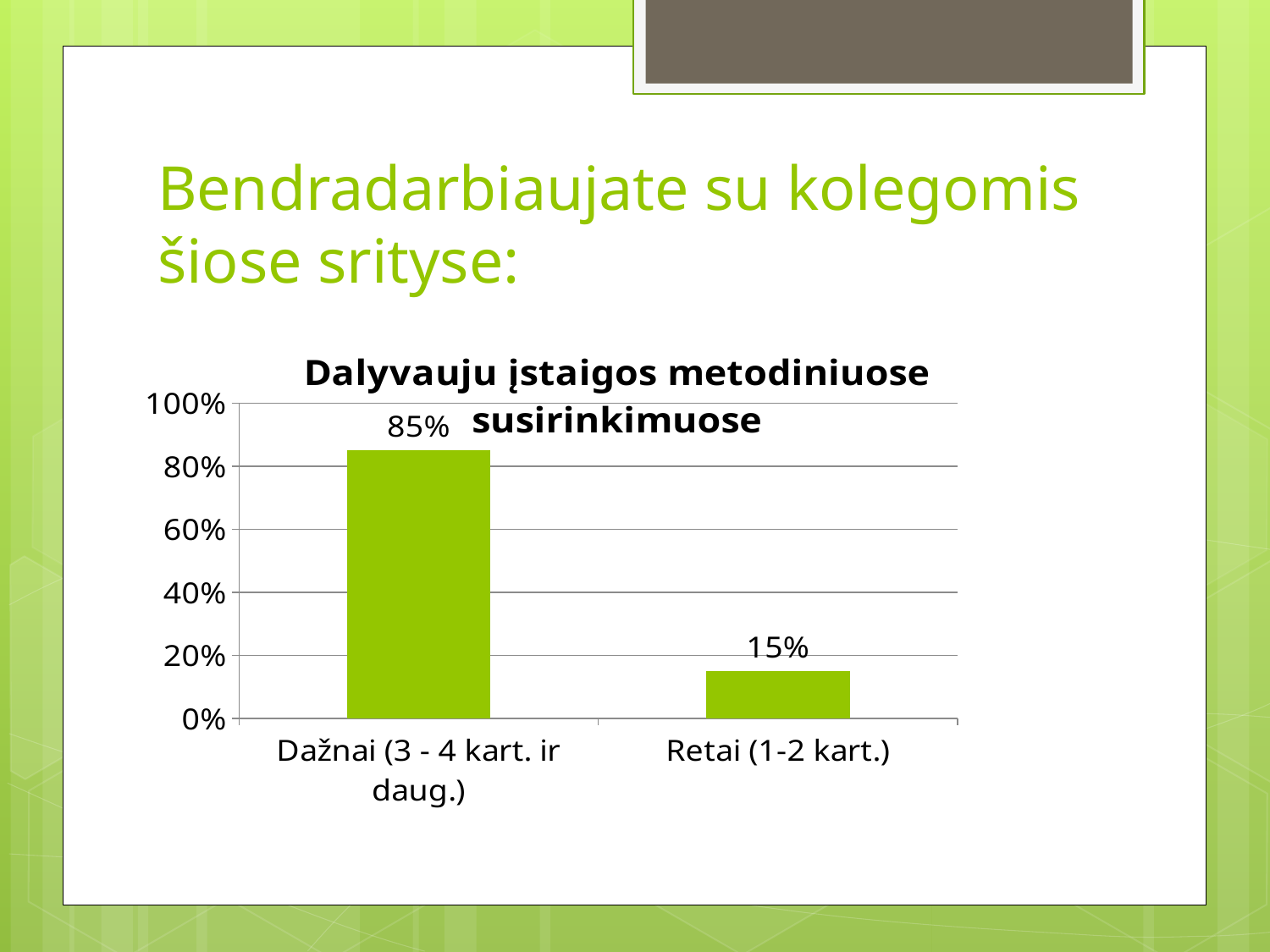
What is the value for "Dažnai (3 - 4 kart. ir daug.)"? 85% What is the title of the chart? Dalyvauju įstaigos metodiniuose susirinkimuose What kind of chart is shown on the slide? bar chart Which category has the lowest value? Retai (1-2 kart.) Is the value for "Dažnai (3 - 4 kart. ir daug.)" greater or less than 80%? greater What is the value for "Retai (1-2 kart.)"? 15% What is the difference between the values for "Dažnai (3 - 4 kart. ir daug.)" and "Retai (1-2 kart.)"? 70% Which category has the highest value? Dažnai (3 - 4 kart. ir daug.) Is the value for "Retai (1-2 kart.)" greater or less than 20%? less How many categories are shown in the chart? 2 What is the maximum value shown on the vertical axis? 100% Which is larger, the value for "Dažnai (3 - 4 kart. ir daug.)" or for "Retai (1-2 kart.)"? Dažnai (3 - 4 kart. ir daug.)